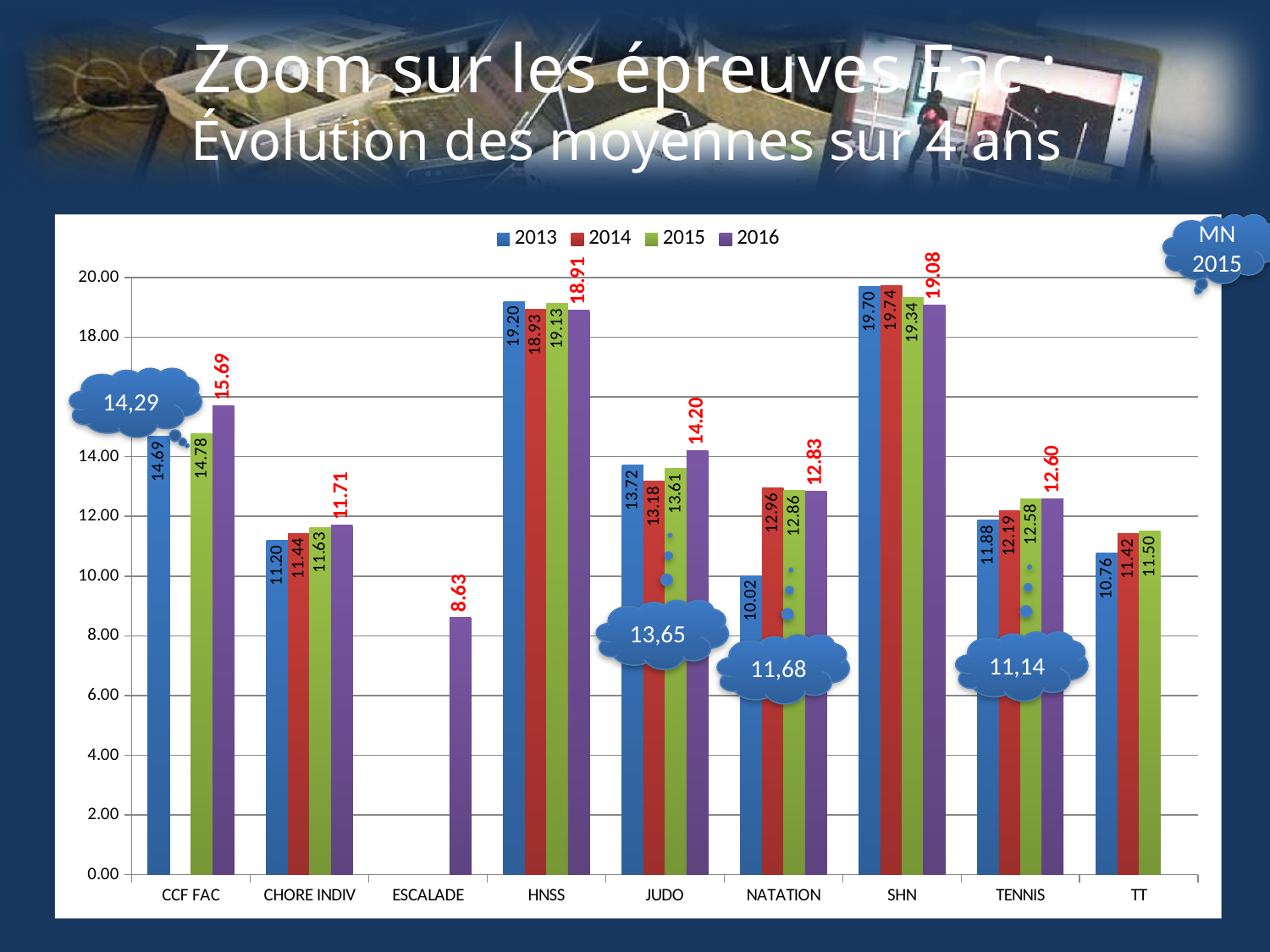
Which category has the lowest 2013 value? NATATION What kind of chart is shown on the slide? bar chart What is the 2016 value for ESCALADE? 8.63 Which category has the highest 2016 value? SHN How many categories are shown on the x axis? 9 For JUDO, which is larger: the 2013 value or the 2016 value? 2016 How many series does the legend list? 4 Do the values for TENNIS rise or fall from 2013 to 2016? rise What is the difference between the 2016 and 2013 values for CCF FAC? 1.00 What is the 2013 value for HNSS? 19.20 What is the difference between the 2014 and 2013 values for NATATION? 2.94 What is the 2015 value for TT? 11.50